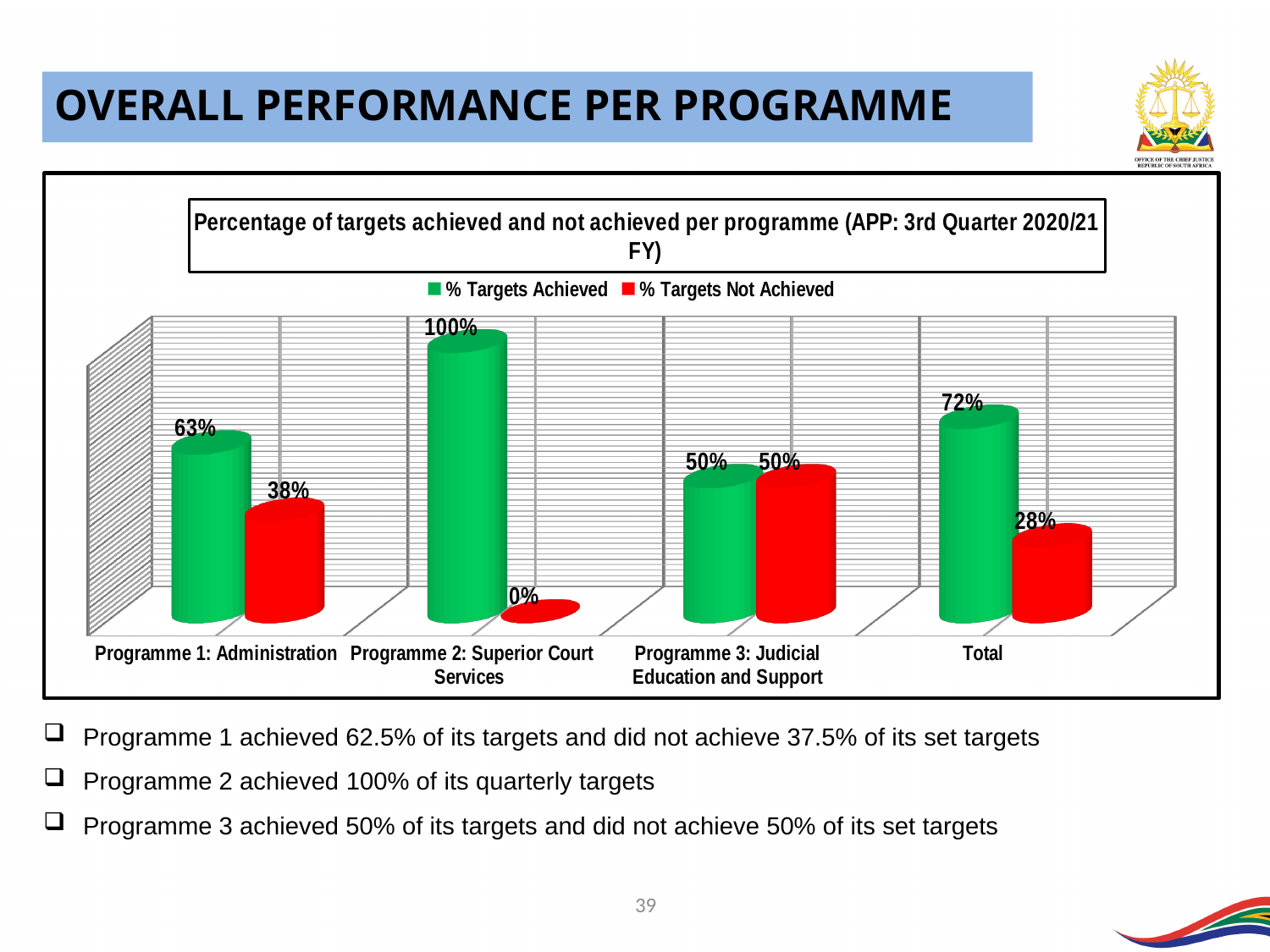
Which is larger for Total: % Targets Achieved or % Targets Not Achieved? % Targets Achieved How many series does the legend list? 2 What is the % Targets Achieved value for Programme 1: Administration? 63% What is the % Targets Not Achieved value for Programme 2: Superior Court Services? 0% What is the % Targets Not Achieved value for Total? 28% Which colour represents % Targets Not Achieved in the legend? Red What kind of chart is shown on the slide? Bar chart What is the title of the chart? Percentage of targets achieved and not achieved per programme (APP: 3rd Quarter 2020/21 FY) How many categories are shown on the x axis? 4 Which category has the highest % Targets Achieved value? Programme 2: Superior Court Services Which category has the lowest % Targets Not Achieved value? Programme 2: Superior Court Services What is the difference between % Targets Achieved and % Targets Not Achieved for Programme 1: Administration? 25%